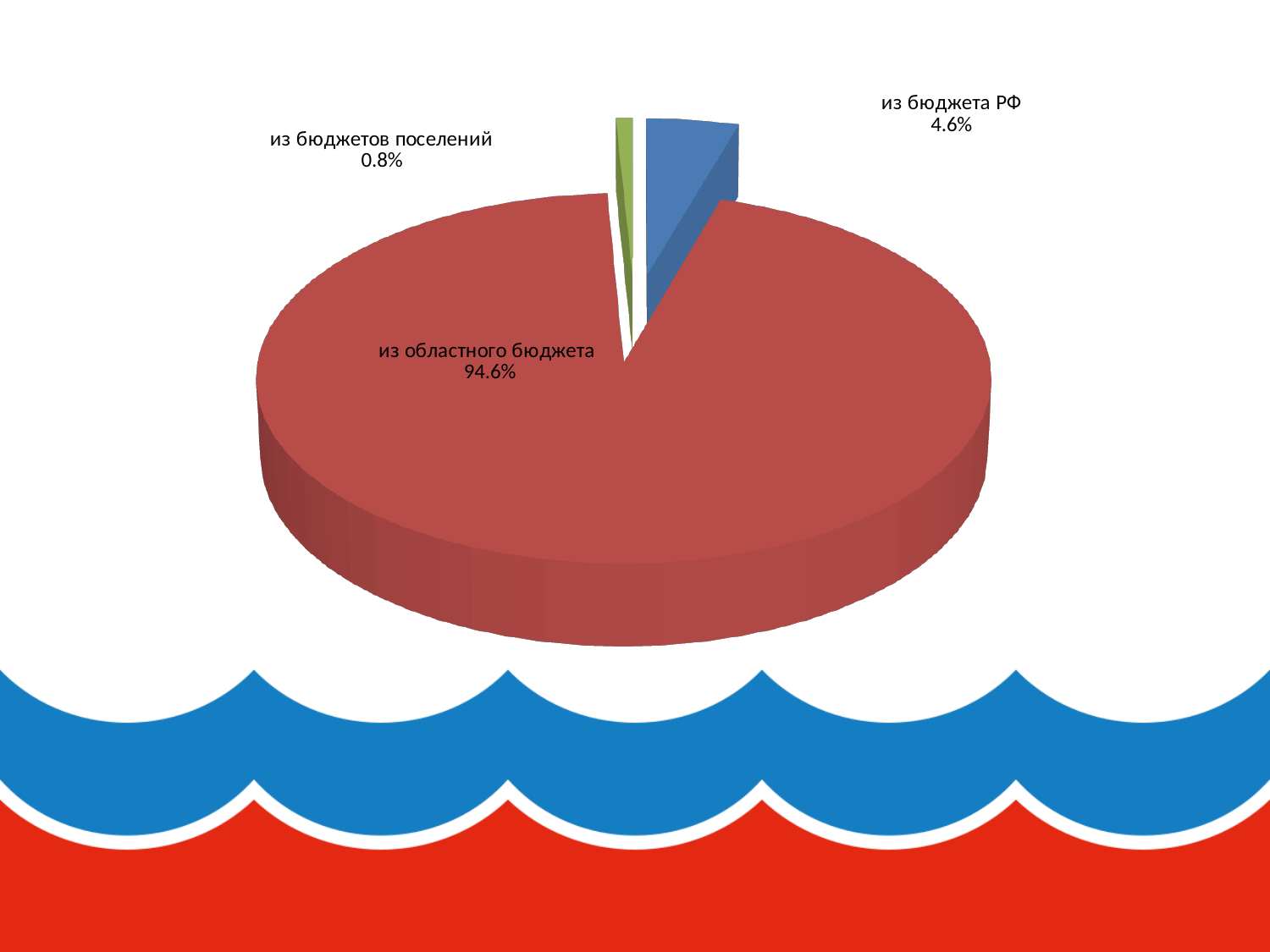
How many slices does the pie chart have? 3 Which category has the smallest slice of the pie? из бюджетов поселений What colour is the slice for "из областного бюджета"? red What share of the pie does "из бюджетов поселений" have? 0.8% What share of the pie does "из областного бюджета" have? 94.6% What share of the pie does "из бюджета РФ" have? 4.6% Which category has the largest slice of the pie? из областного бюджета What colour is the slice for "из бюджета РФ"? blue What kind of chart is shown on the slide? pie chart What is the difference in percentage points between "из бюджета РФ" and "из бюджетов поселений"? 3.8 Which is larger: the share for "из бюджета РФ" or the share for "из бюджетов поселений"? из бюджета РФ What is the difference in percentage points between "из областного бюджета" and "из бюджета РФ"? 90